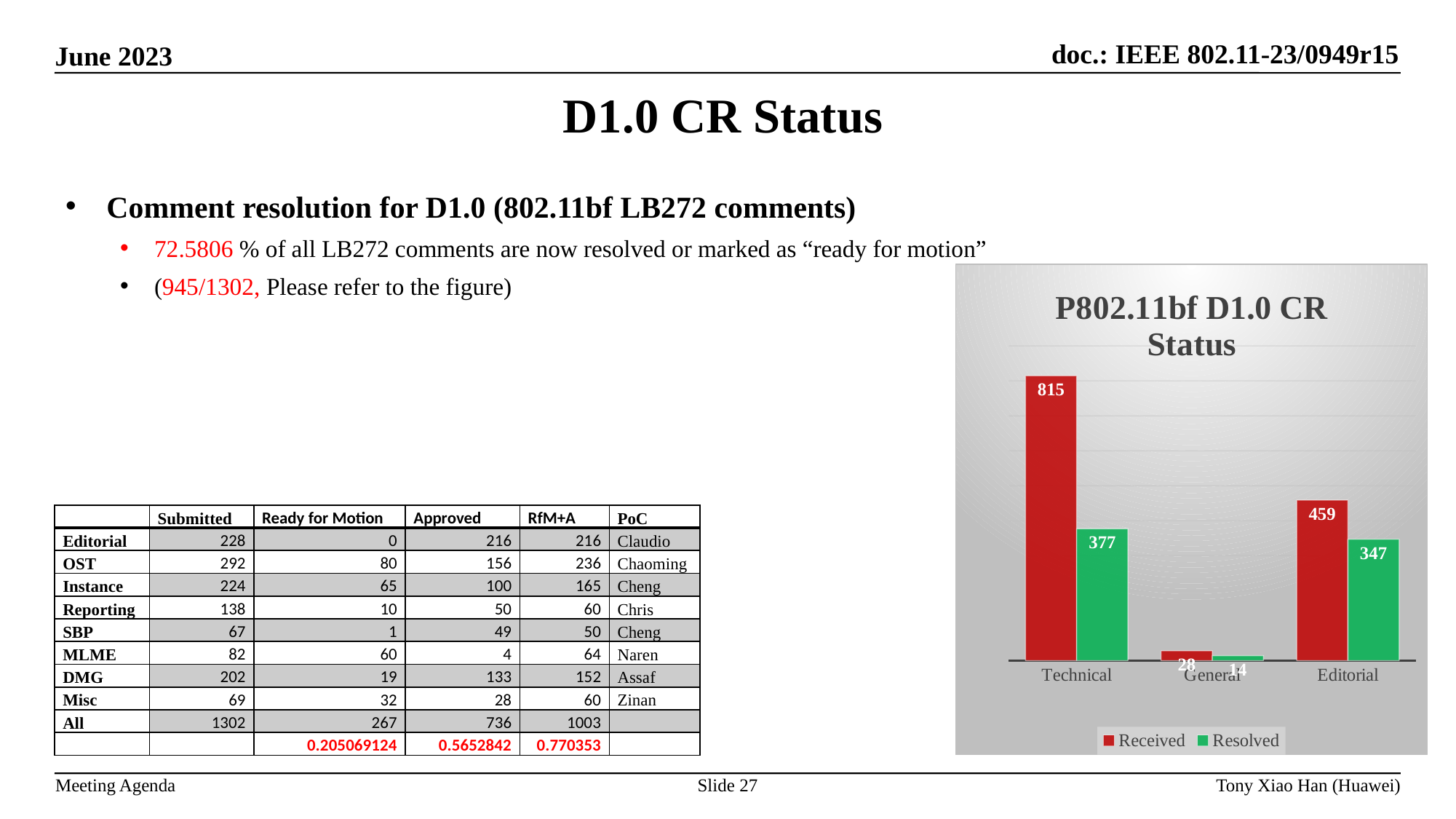
What is the Received value for Technical? 815 What is the Resolved value for Technical? 377 What type of chart is shown on the slide? Bar chart Which category has the lowest Resolved value? General Which category has the highest Received value? Technical What is the Received value for General? 28 Which is larger, the Resolved value for Editorial or the Resolved value for Technical? Technical How many categories are shown on the x axis of the chart? 3 What is the difference between Received and Resolved for Technical? 438 What is the Resolved value for Editorial? 347 What is the difference between Received and Resolved for Editorial? 112 How many series does the chart legend list? 2